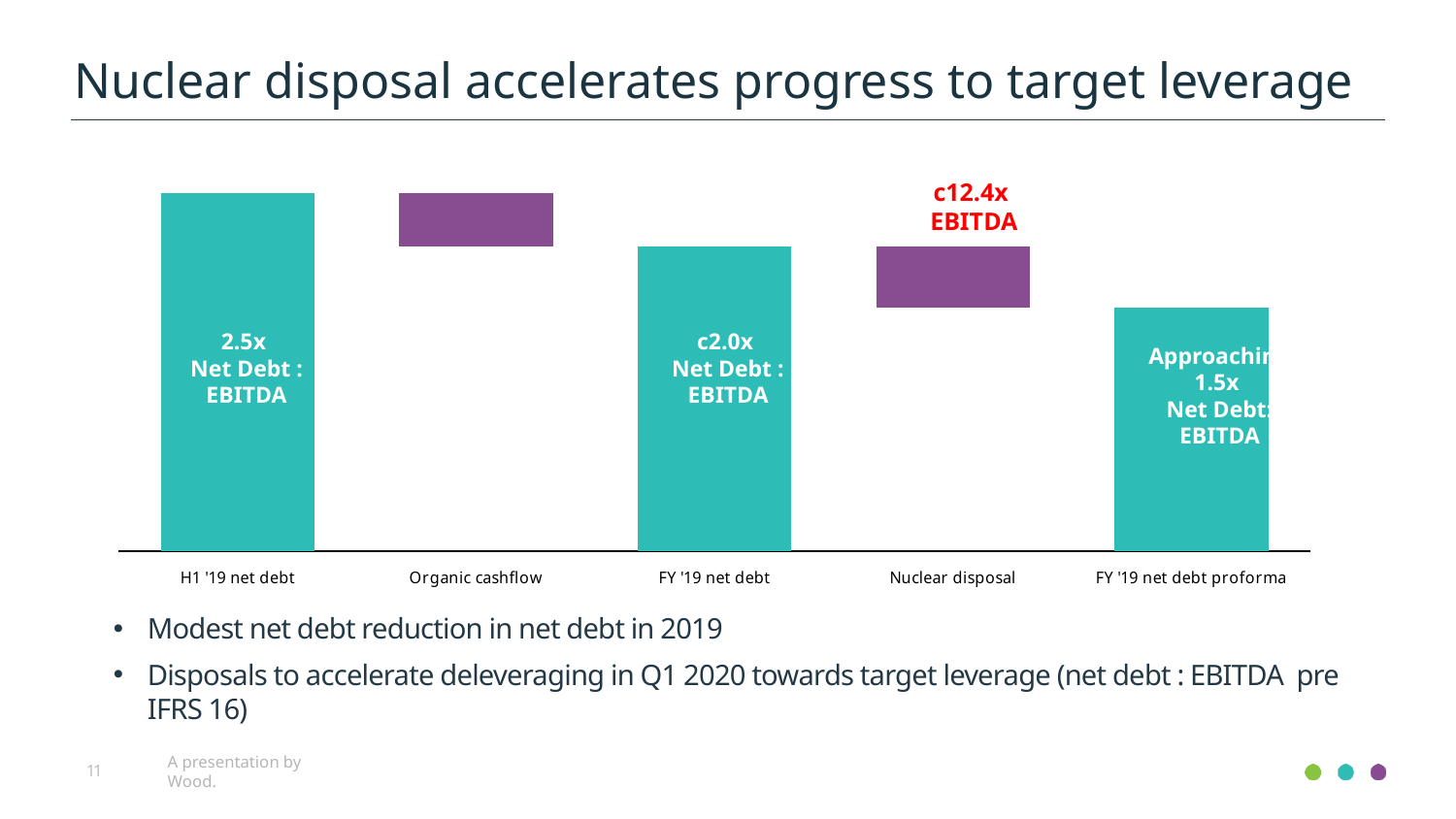
What colour are the Organic cashflow and Nuclear disposal bars? Purple What Net Debt : EBITDA ratio is labelled on the FY '19 net debt proforma bar? Approaching 1.5x How many categories are shown along the x axis of the chart? 5 Which bar is taller, H1 '19 net debt or FY '19 net debt? H1 '19 net debt Do the net debt bars rise or fall from H1 '19 net debt to FY '19 net debt proforma? Fall What Net Debt : EBITDA ratio is labelled on the H1 '19 net debt bar? 2.5x What kind of chart is shown on the slide? Bar chart (waterfall) Which reduction bar is larger, Organic cashflow or Nuclear disposal? Nuclear disposal What label is shown above the Nuclear disposal bar? c12.4x EBITDA Which category has the tallest bar in the chart? H1 '19 net debt What Net Debt : EBITDA ratio is labelled on the FY '19 net debt bar? c2.0x Which of the net debt bars (H1 '19, FY '19, FY '19 proforma) is the lowest? FY '19 net debt proforma